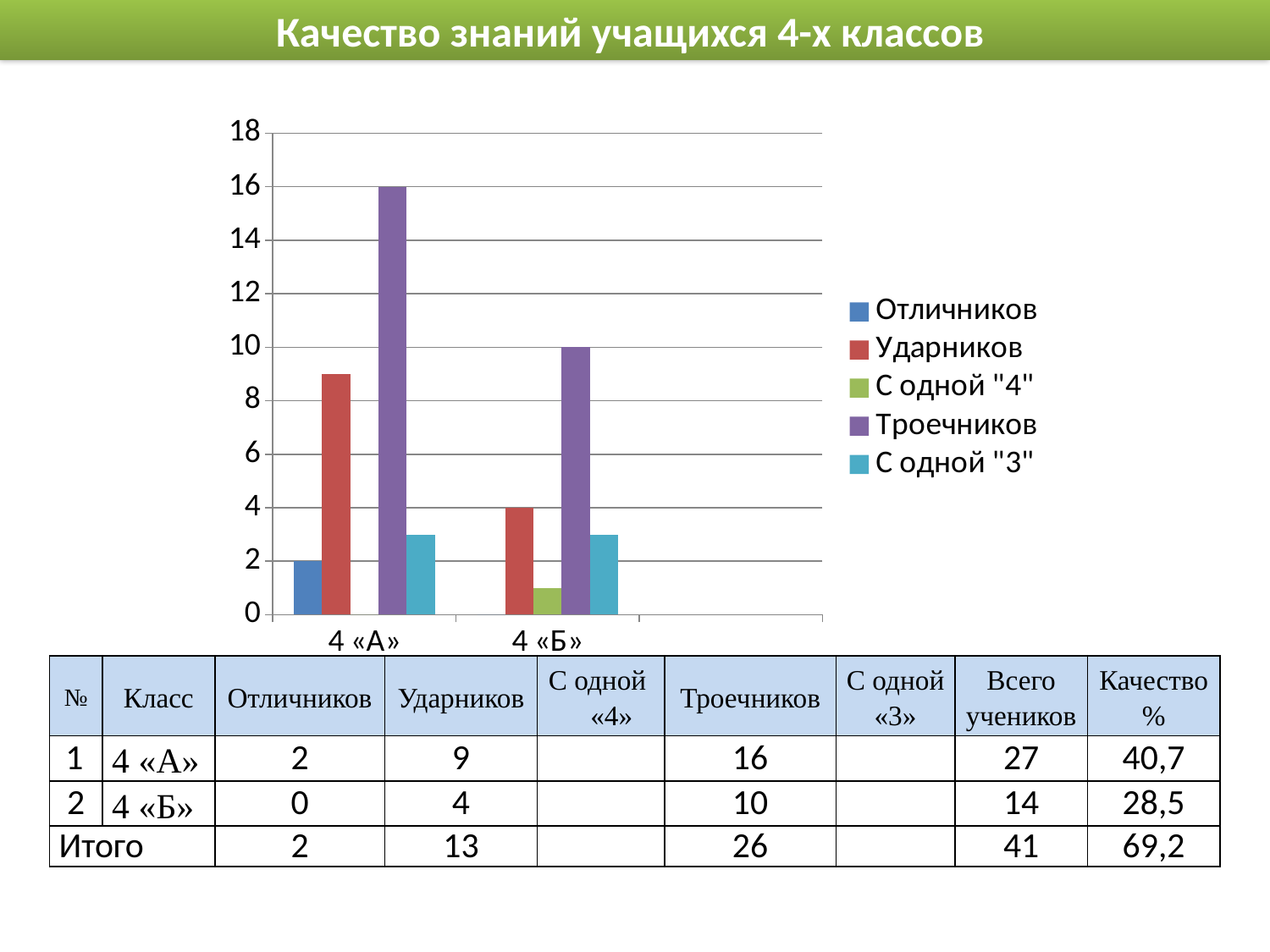
How many series does the chart legend list? 5 How many class categories are shown on the x axis of the chart? 2 Which class has the larger Троечников value, 4 «А» or 4 «Б»? 4 «А» What is the value of Троечников for class 4 «А»? 16 Is the value of С одной "3" for class 4 «А» greater or less than 4? less What is the difference between the Ударников values for 4 «А» and 4 «Б»? 5 Is the value of Троечников for class 4 «Б» greater or less than 8? greater What colour are the Троечников bars in the chart? purple What kind of chart is shown on the slide? bar chart What is the value of Отличников for class 4 «А»? 2 What is the value of Ударников for class 4 «Б»? 4 Which series has the highest bar for class 4 «Б»? Троечников